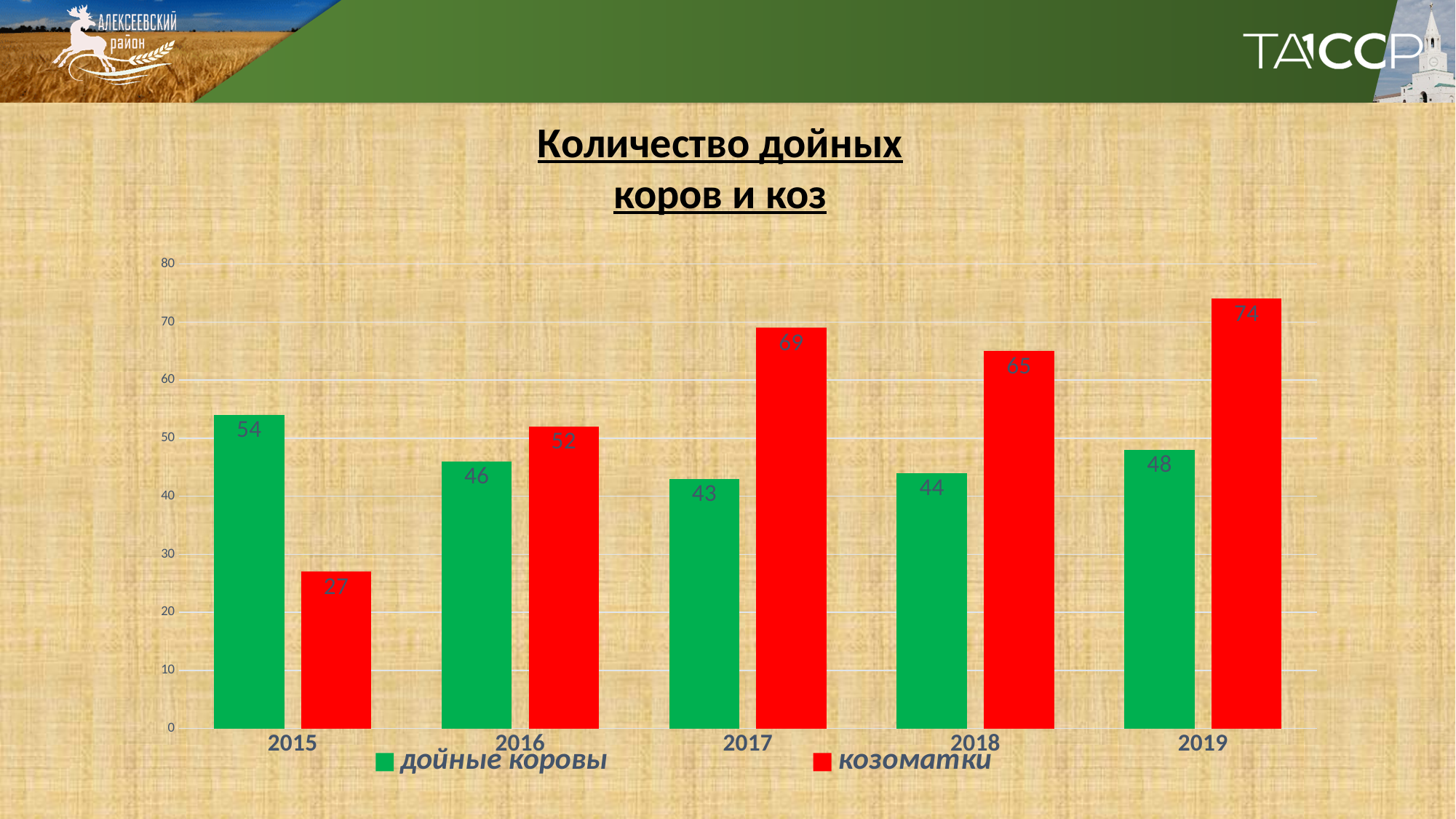
In which year is the value for дойные коровы highest? 2015 How many series does the legend list? 2 What kind of chart is shown on the slide? bar chart How many years are shown on the x axis? 5 Which is larger in 2016: дойные коровы or козоматки? козоматки What is the value for козоматки in 2017? 69 In which year is the value for козоматки lowest? 2015 What is the value for дойные коровы in 2015? 54 Which is larger in 2015: дойные коровы or козоматки? дойные коровы Which colour represents козоматки in the chart? red What is the difference between козоматки and дойные коровы in 2019? 26 What is the value for козоматки in 2019? 74